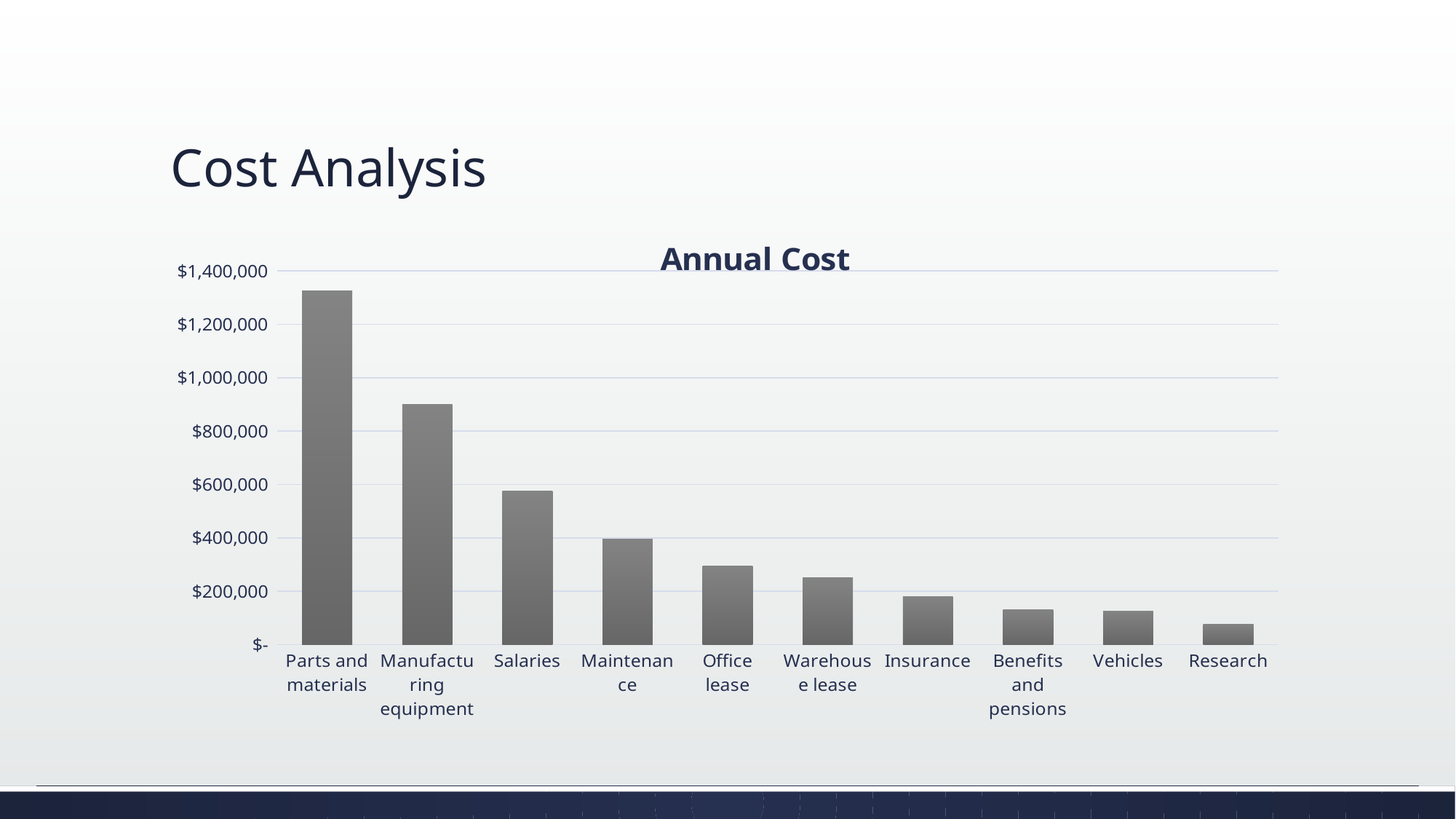
Which has the larger annual cost, Salaries or Maintenance? Salaries Is the value for Office lease greater or less than $400,000? less Is the value for Parts and materials greater or less than $1,200,000? greater How many cost categories are plotted in the chart? 10 Which category has the highest annual cost? Parts and materials Is the value for Manufacturing equipment greater or less than $800,000? greater What kind of chart is shown on the slide? Bar chart Do the values rise or fall moving from left to right along the x axis? Fall Which category has the lowest annual cost? Research What is the title of the chart? Annual Cost